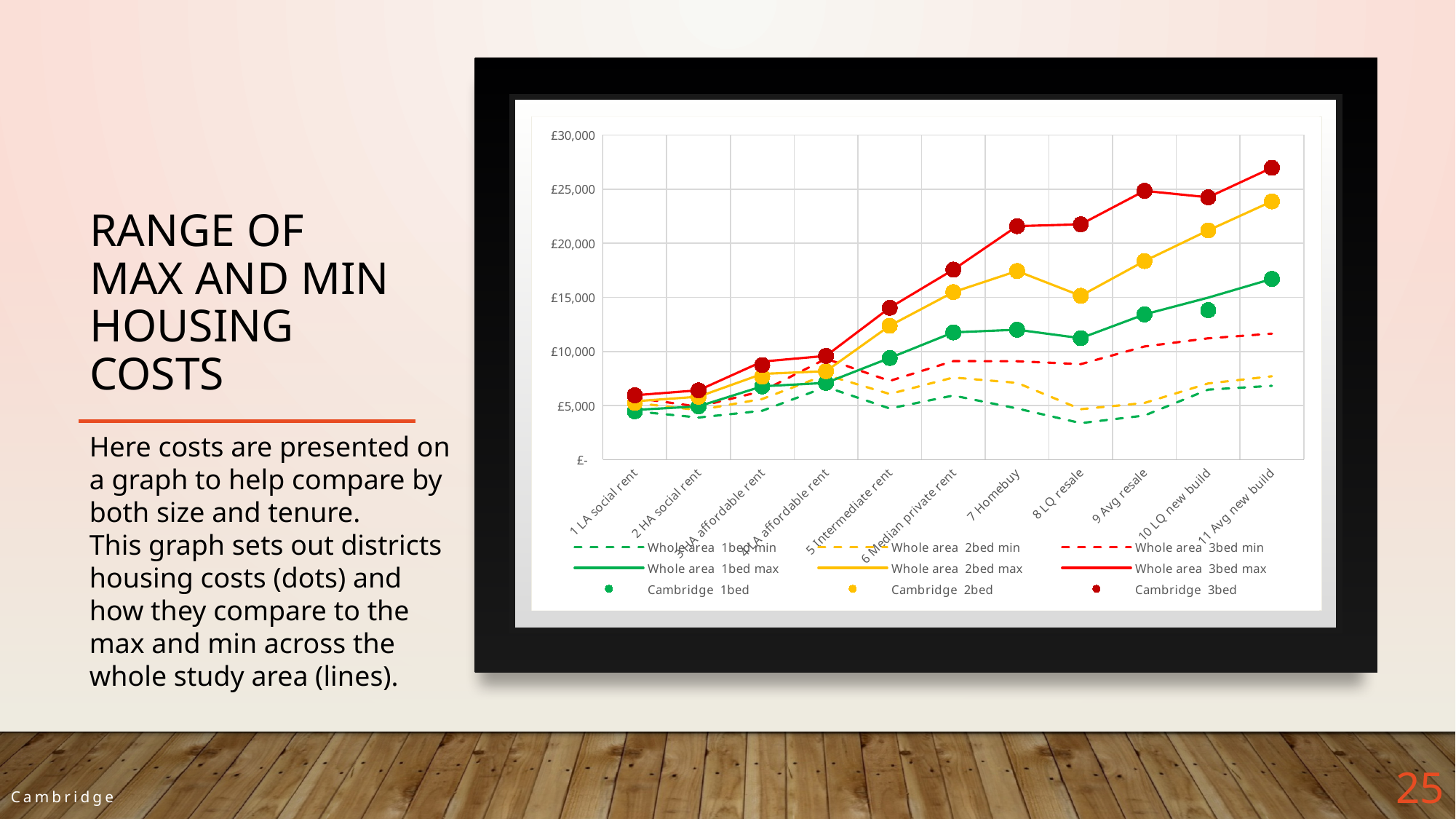
Which is larger for Cambridge 2bed: the value for 7 Homebuy or the value for 8 LQ resale? 7 Homebuy Is the Cambridge 2bed value for 7 Homebuy greater or less than £15,000? greater Is the Whole area 3bed max value for 7 Homebuy greater or less than £20,000? greater Which category has the lowest Cambridge 1bed value? 1 LA social rent What colour is used for the 3bed series in the chart? Red What kind of chart is shown on the slide? Line chart How many categories are shown along the x axis of the chart? 11 How many series does the chart's legend list? 9 Does the Whole area 3bed max line generally rise or fall from 1 LA social rent to 11 Avg new build? Rise Which category has the highest Cambridge 3bed value? 11 Avg new build Is the Cambridge 1bed value for 1 LA social rent greater or less than £5,000? less